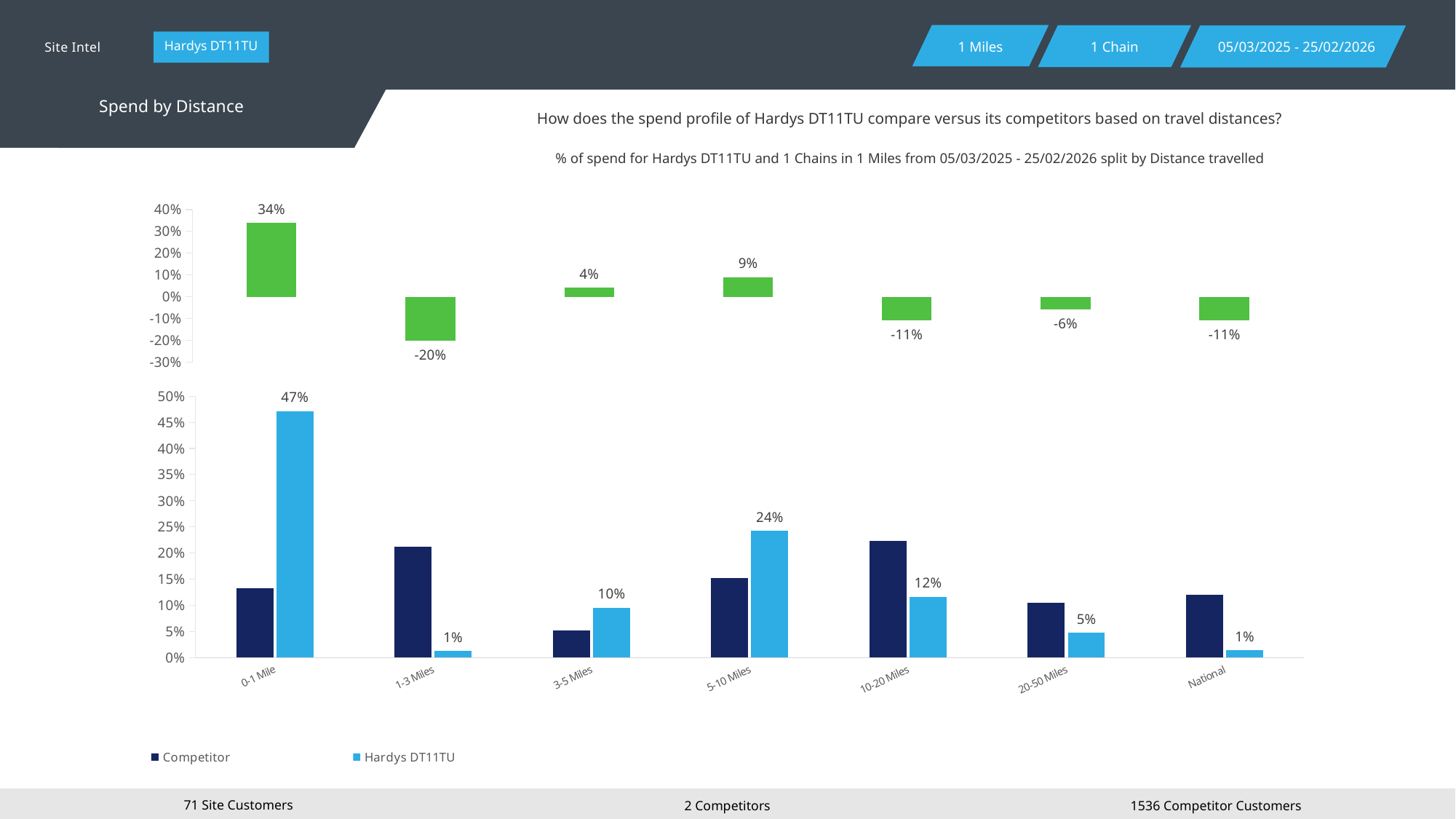
In the bottom chart, is the Competitor value for 10-20 Miles greater or less than 20%? greater How many distance categories are shown on the x axis of the bottom chart? 7 In the bottom chart, what is the value for Hardys DT11TU in the 5-10 Miles category? 24% How many series does the legend of the bottom chart list? 2 In the top chart, which distance category has the lowest value? 1-3 Miles What kind of chart is the bottom chart? Bar chart In the top chart, what is the value shown for 1-3 Miles? -20% In the bottom chart, is the Competitor value for 3-5 Miles greater or less than 10%? less In the bottom chart, which series has the larger value in the 1-3 Miles category, Competitor or Hardys DT11TU? Competitor In the top chart, which distance category has the highest value? 0-1 Mile In the bottom chart, what is the difference between the Hardys DT11TU values for 0-1 Mile and 5-10 Miles? 23% In the bottom chart, what is the value for Hardys DT11TU in the 0-1 Mile category? 47%